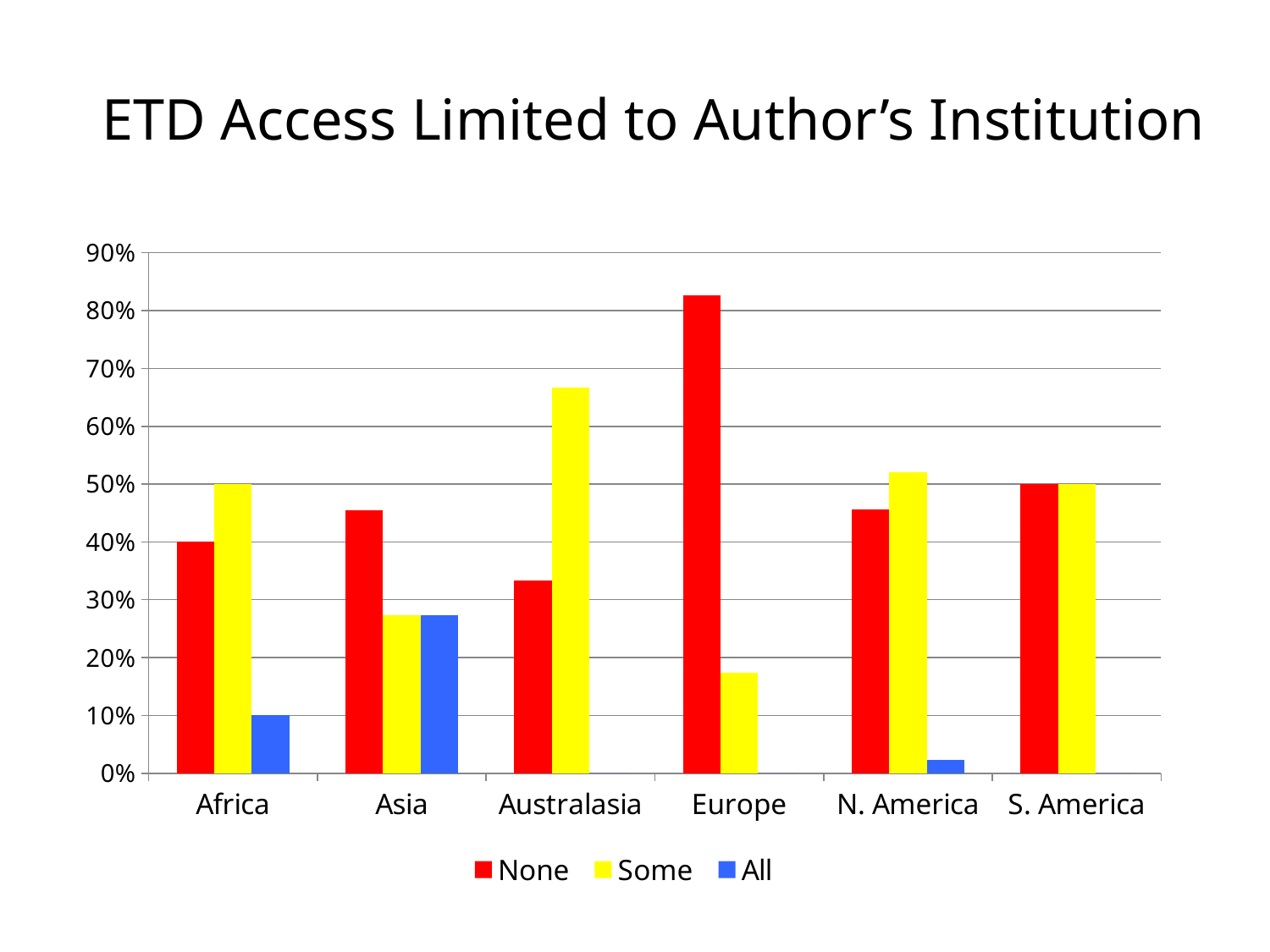
What is the value of the All series for Africa? 10% Which region has the highest value for the None series? Europe Which region has the lowest value for the None series? Australasia What is the value of the None series for S. America? 50% How many series does the legend list? 3 For Africa, which is larger: the None value or the Some value? Some How many regions are shown on the x axis? 6 Is the Some value for Europe greater or less than 20%? less Is the All value for N. America greater or less than 10%? less What is the value of the None series for Africa? 40% Which region has the highest value for the Some series? Australasia Is the None value for Europe greater or less than 80%? greater